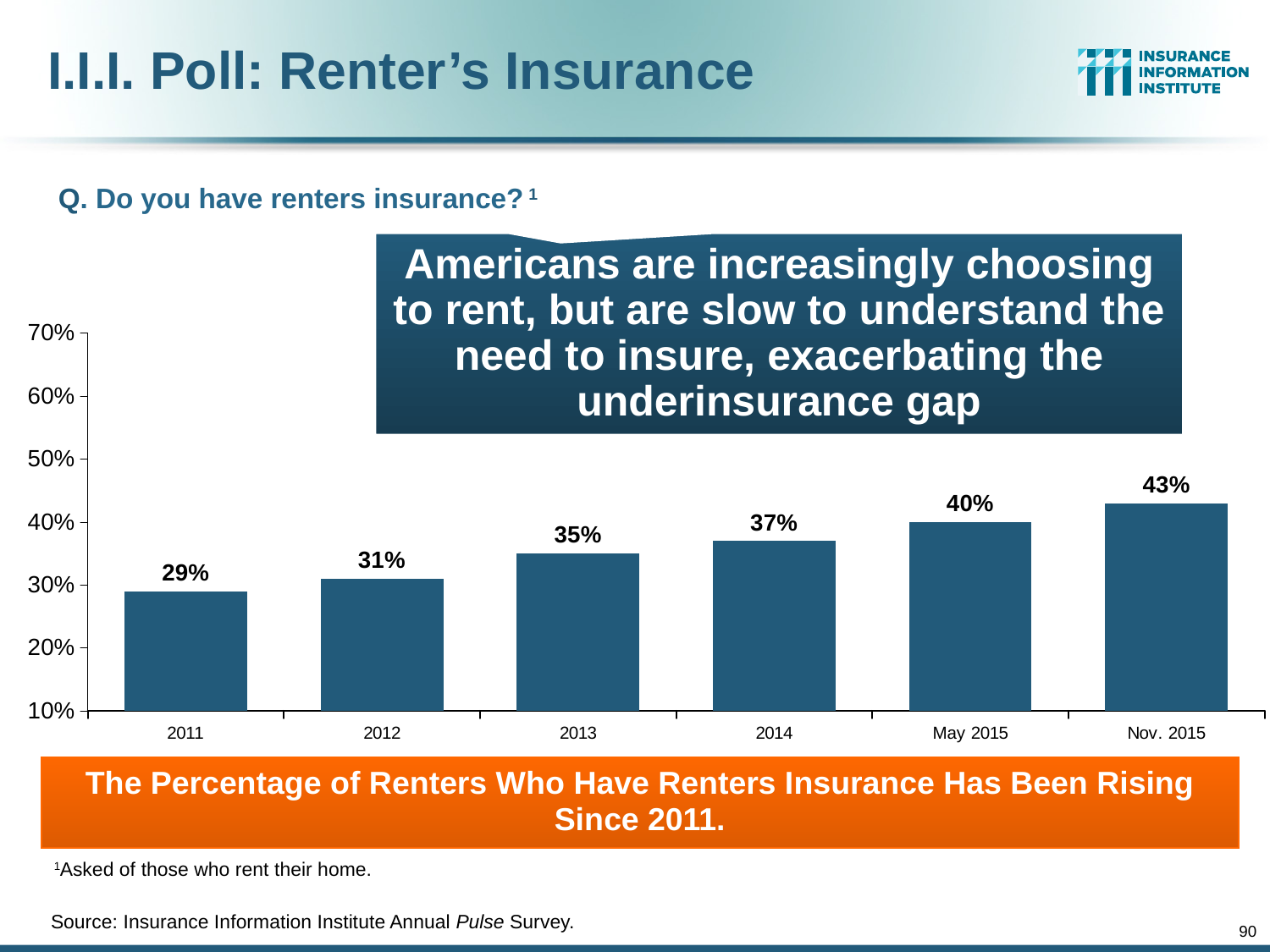
Which category has the highest value? Nov. 2015 What is the value shown for May 2015? 40% What is the difference between the Nov. 2015 value and the 2011 value? 14% Which is larger, the value for 2012 or the value for 2014? 2014 What is the value shown for 2013? 35% Is the value for Nov. 2015 greater or less than 40%? greater What percentage of renters had renters insurance in 2011? 29% What is the difference between the 2014 value and the 2012 value? 6% What kind of chart is shown on the slide? Bar chart How many categories are shown on the x axis? 6 Which category has the lowest value? 2011 Do the values rise or fall from 2011 to Nov. 2015? Rise